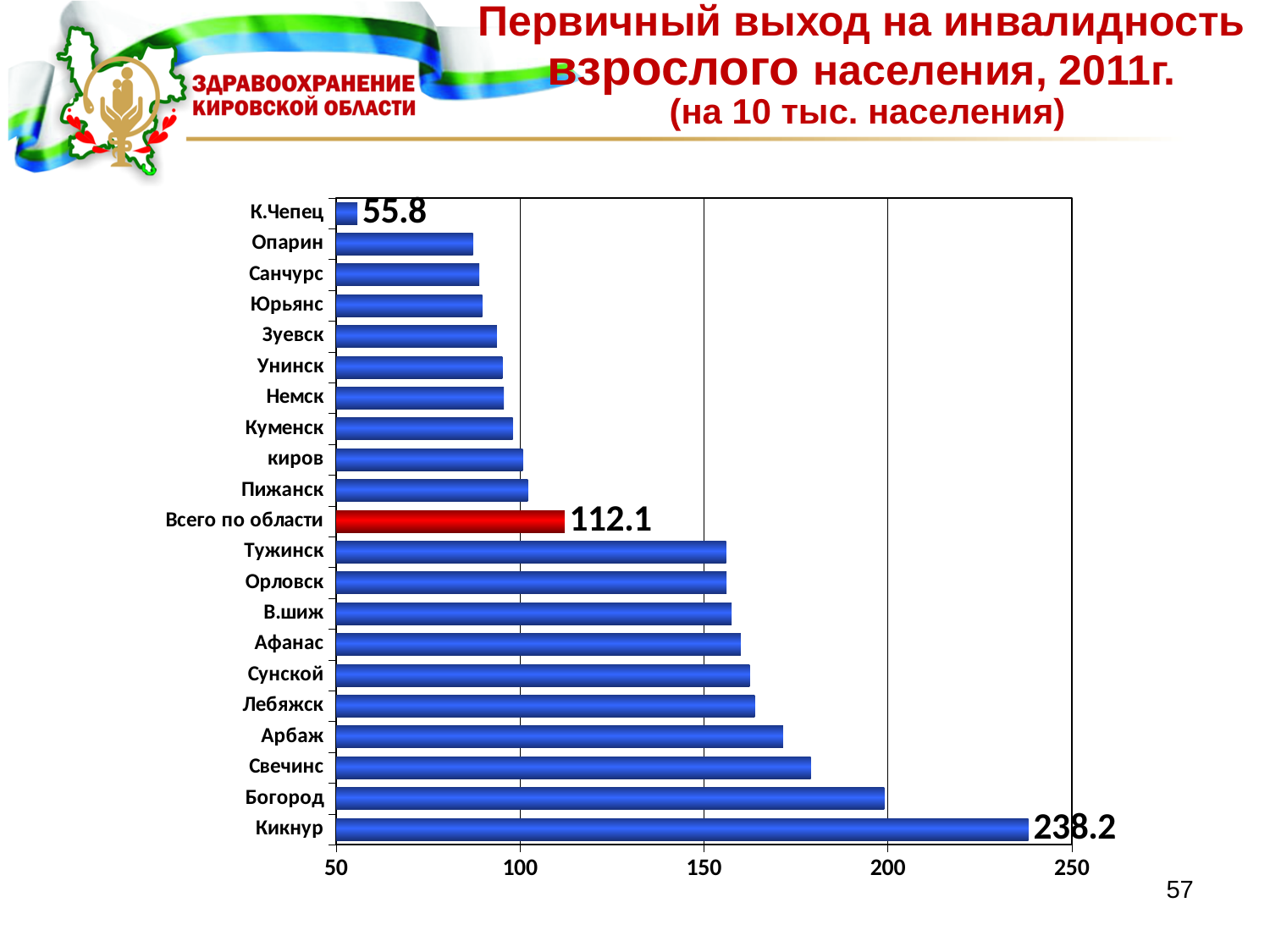
How many categories are shown in the chart? 21 Which category has the lowest value? К.Чепец Which is larger, the value for Свечинс or the value for Опарин? Свечинс What is the difference between the values for Кикнур and Всего по области? 126.1 What is the value for К.Чепец? 55.8 Is the value for Арбаж greater or less than 150? greater What kind of chart is shown on the slide? bar chart What is the value for Кикнур? 238.2 Which category has the highest value? Кикнур Is the value for Опарин greater or less than 100? less What is the difference between the values for Кикнур and К.Чепец? 182.4 What is the value for Всего по области? 112.1